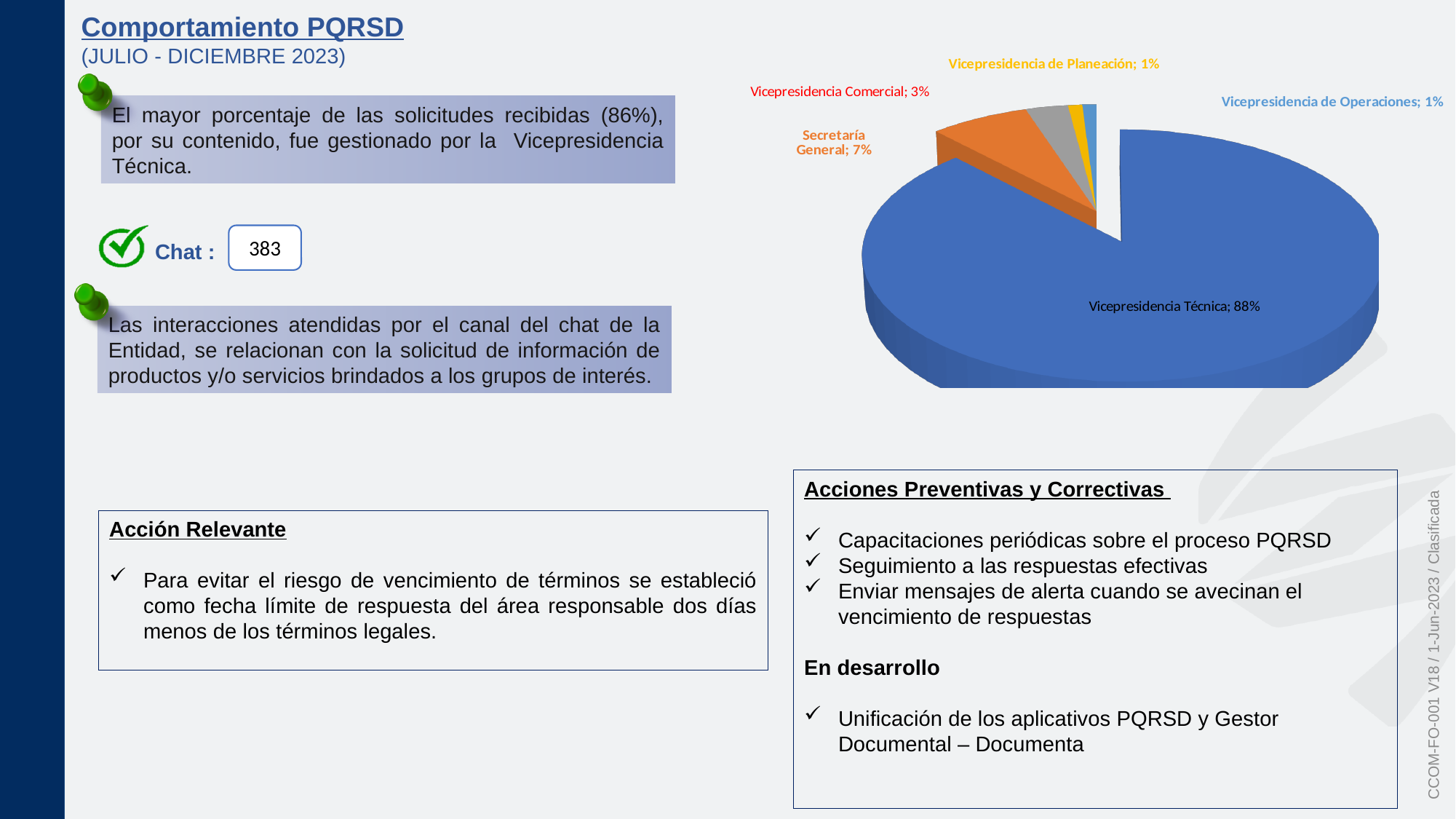
What type of chart is shown on the slide? Pie chart How many slices (categories) does the pie chart have? 5 What is the value shown for Vicepresidencia Comercial in the pie chart? 3% Which category has the largest slice in the pie chart? Vicepresidencia Técnica What is the difference in percentage points between Secretaría General and Vicepresidencia Comercial in the pie chart? 4 What percentage of the pie chart corresponds to Vicepresidencia Técnica? 88% What percentage does the pie chart show for Vicepresidencia de Planeación? 1% What percentage does the pie chart show for Vicepresidencia de Operaciones? 1% What share of the pie chart does Secretaría General represent? 7% What is the difference in percentage points between Vicepresidencia Técnica and Secretaría General in the pie chart? 81 What colour is the Vicepresidencia Técnica slice in the pie chart? Blue Which is larger in the pie chart, Secretaría General or Vicepresidencia Comercial? Secretaría General